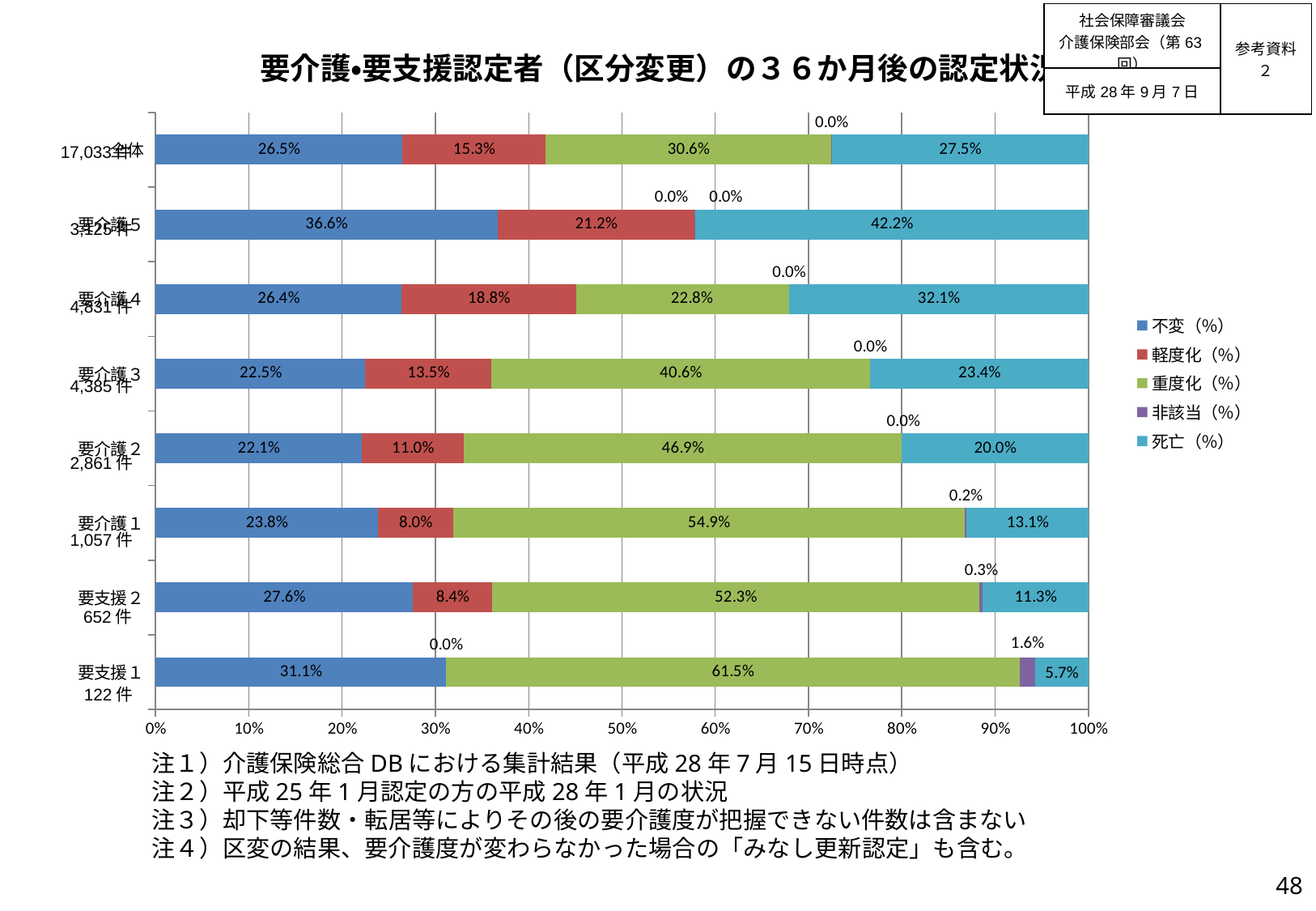
How many category bars are plotted in the chart? 8 How many series does the legend list? 5 Which category has the lowest 死亡（%） value? 要支援1 What is the 非該当（%） value for 要支援2? 0.3% What is the 重度化（%） value for 要支援1? 61.5% What is the difference between the 重度化（%） values for 要介護1 and 要介護2? 8.0% What kind of chart is shown on the slide? Stacked bar chart What is the 死亡（%） value for 全体? 27.5% What is the 不変（%） value for 要介護5? 36.6% Which is larger, the 軽度化（%） value for 要介護4 or for 要介護3? 要介護4 Which legend entry is shown in green? 重度化（%） Which category has the highest 死亡（%） value? 要介護5